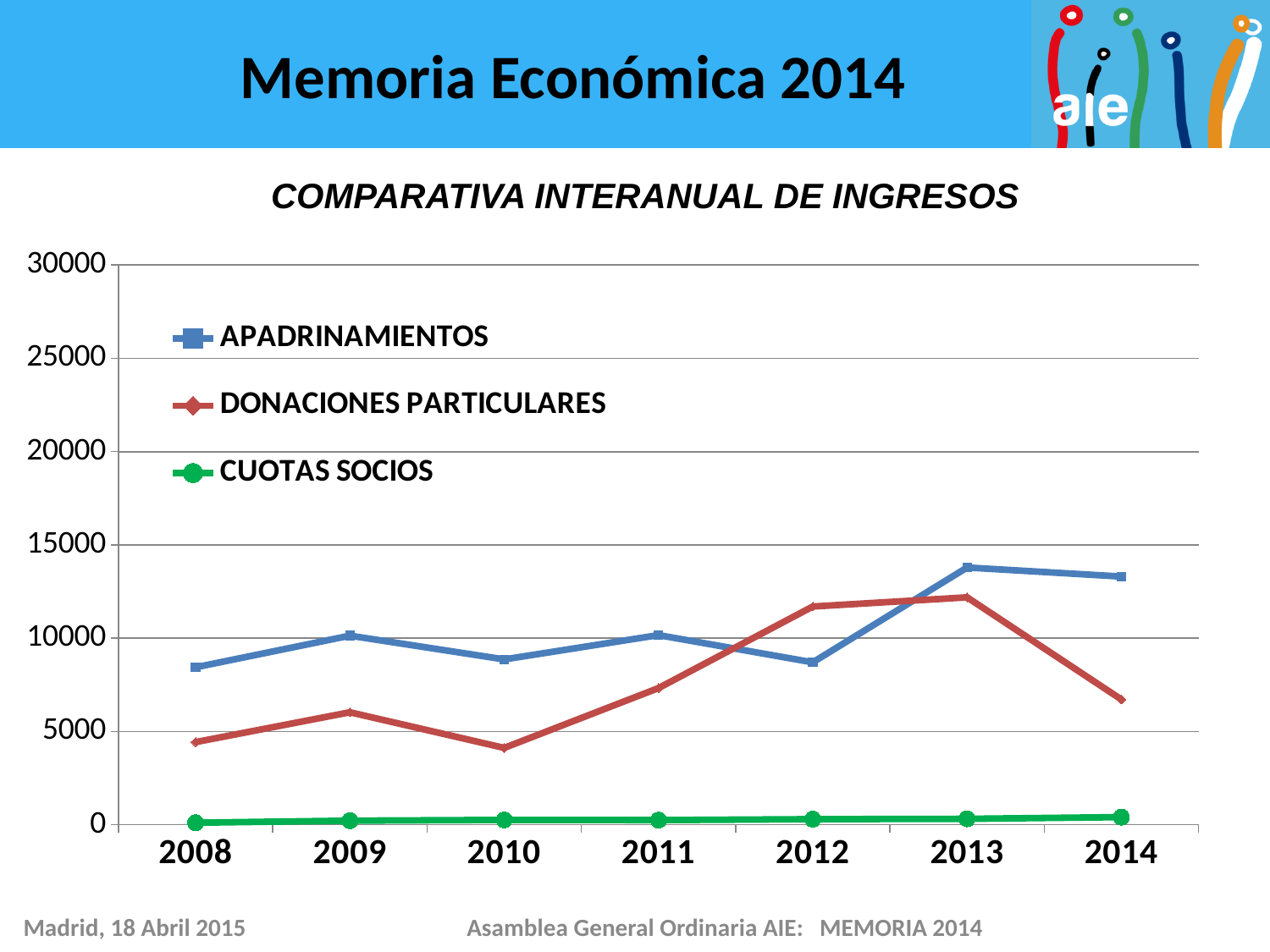
Is the value for DONACIONES PARTICULARES in 2010 greater or less than 5000? less Does DONACIONES PARTICULARES rise or fall from 2013 to 2014? fall In which year does APADRINAMIENTOS reach its highest value? 2013 How many series does the legend list? 3 Which series has the larger value in 2012, APADRINAMIENTOS or DONACIONES PARTICULARES? DONACIONES PARTICULARES Which series is drawn in green? CUOTAS SOCIOS In which year does DONACIONES PARTICULARES reach its lowest value? 2010 What kind of chart is shown on the slide? line chart Is the value for APADRINAMIENTOS in 2013 greater or less than 10000? greater What is the title of the chart? COMPARATIVA INTERANUAL DE INGRESOS How many years are plotted along the x axis? 7 Which series has the highest value in 2014? APADRINAMIENTOS